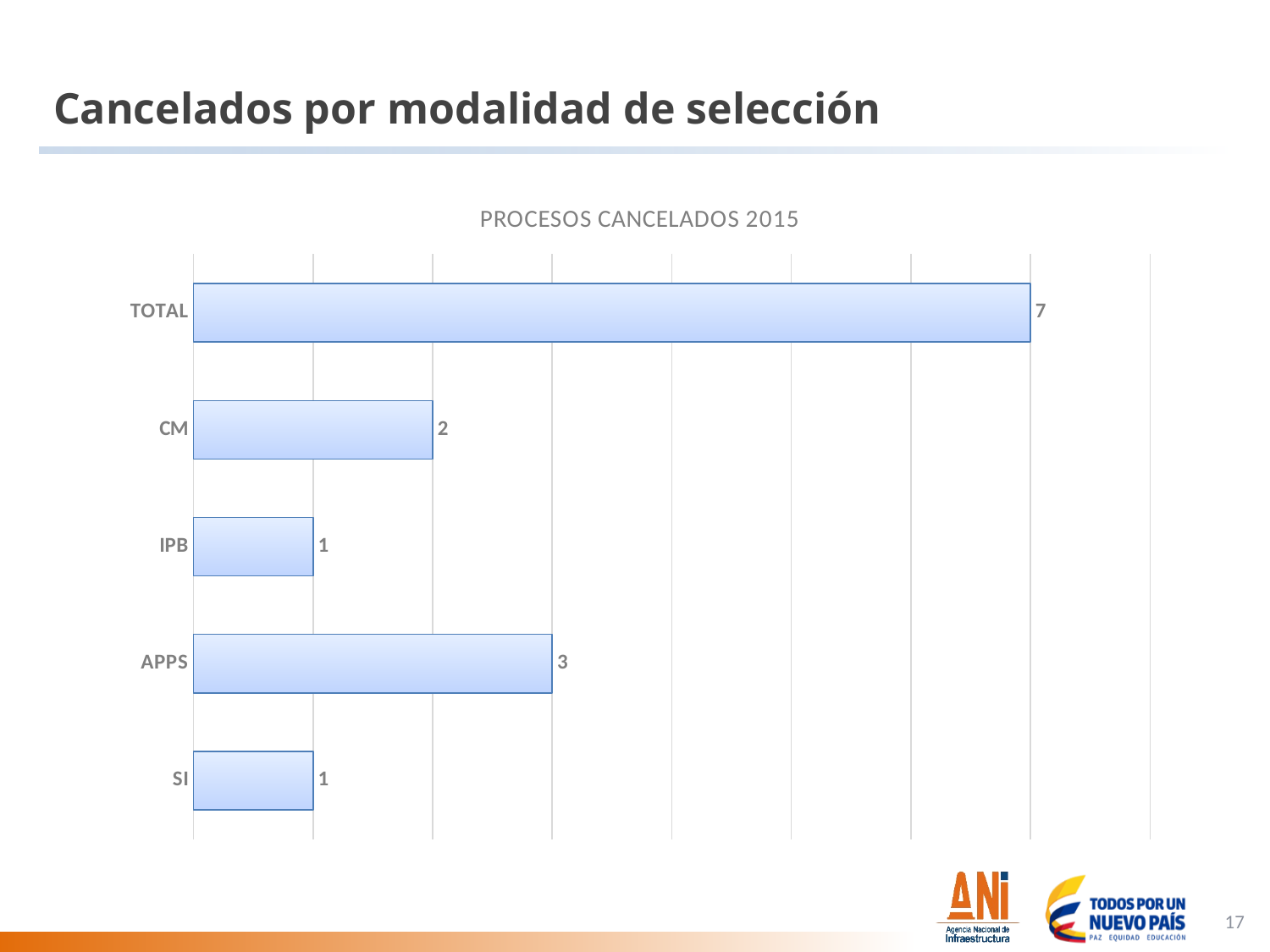
What is the value for SI? 1 What kind of chart is shown on the slide? Bar chart What is the difference between the values for APPS and CM? 1 What is the difference between the values for TOTAL and APPS? 4 Excluding TOTAL, which category has the highest value? APPS What is the value for IPB? 1 What is the value for TOTAL in the PROCESOS CANCELADOS 2015 chart? 7 Which is larger, the value for CM or the value for APPS? APPS What is the title of the chart? PROCESOS CANCELADOS 2015 What is the value for APPS? 3 How many categories are shown on the chart? 5 What is the value for CM? 2